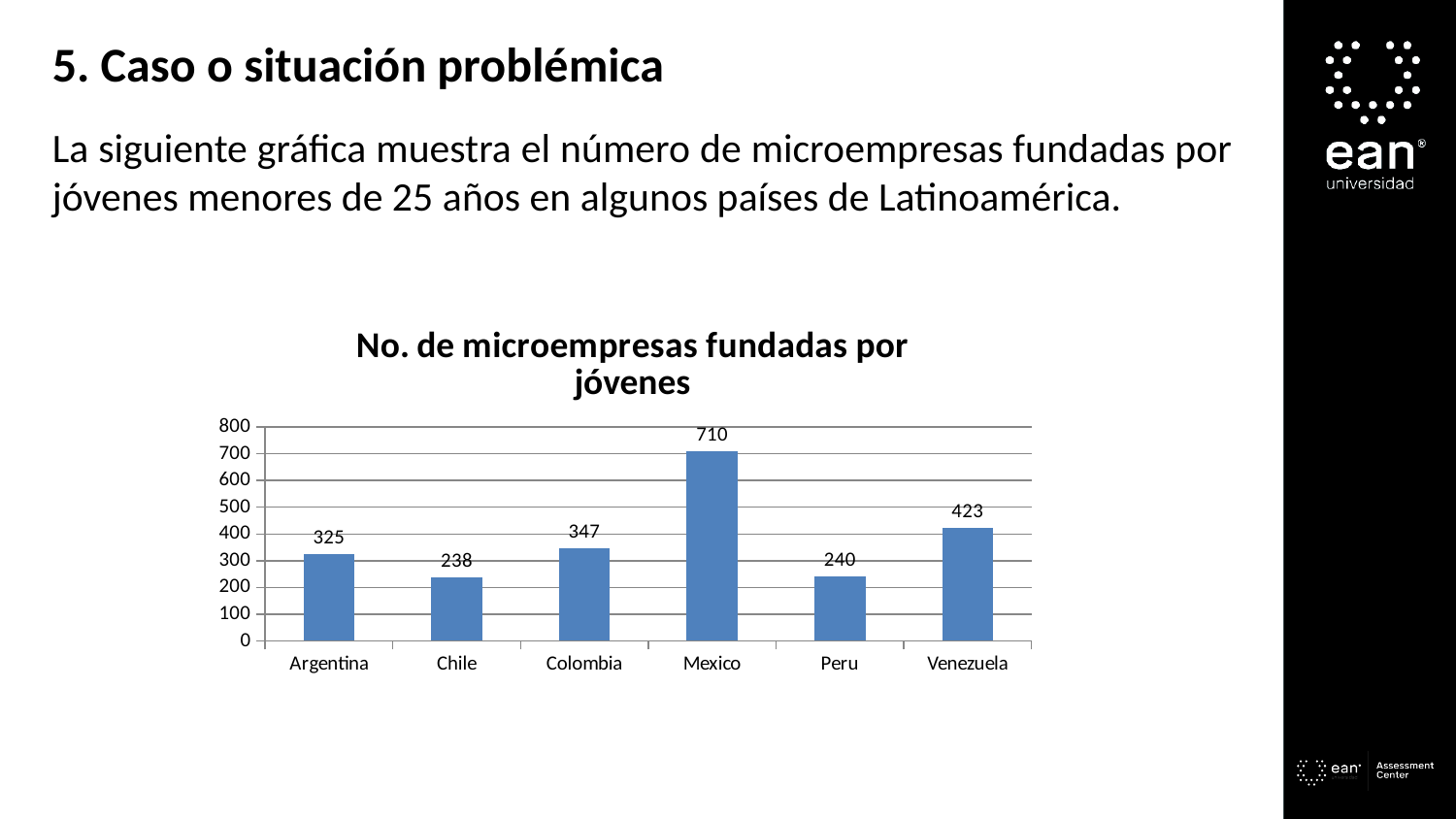
What is the value for Venezuela? 423 What is the value for Mexico? 710 Which country has the lowest number of microempresas? Chile Which is larger, the value for Argentina or the value for Peru? Argentina What kind of chart is shown on the slide? bar chart What is the difference between the values for Colombia and Argentina? 22 Which country has the highest number of microempresas? Mexico How many countries are shown on the chart? 6 Is the value for Venezuela greater or less than 400? greater What is the difference between the values for Mexico and Venezuela? 287 What is the title of the chart? No. de microempresas fundadas por jóvenes What is the value for Chile? 238